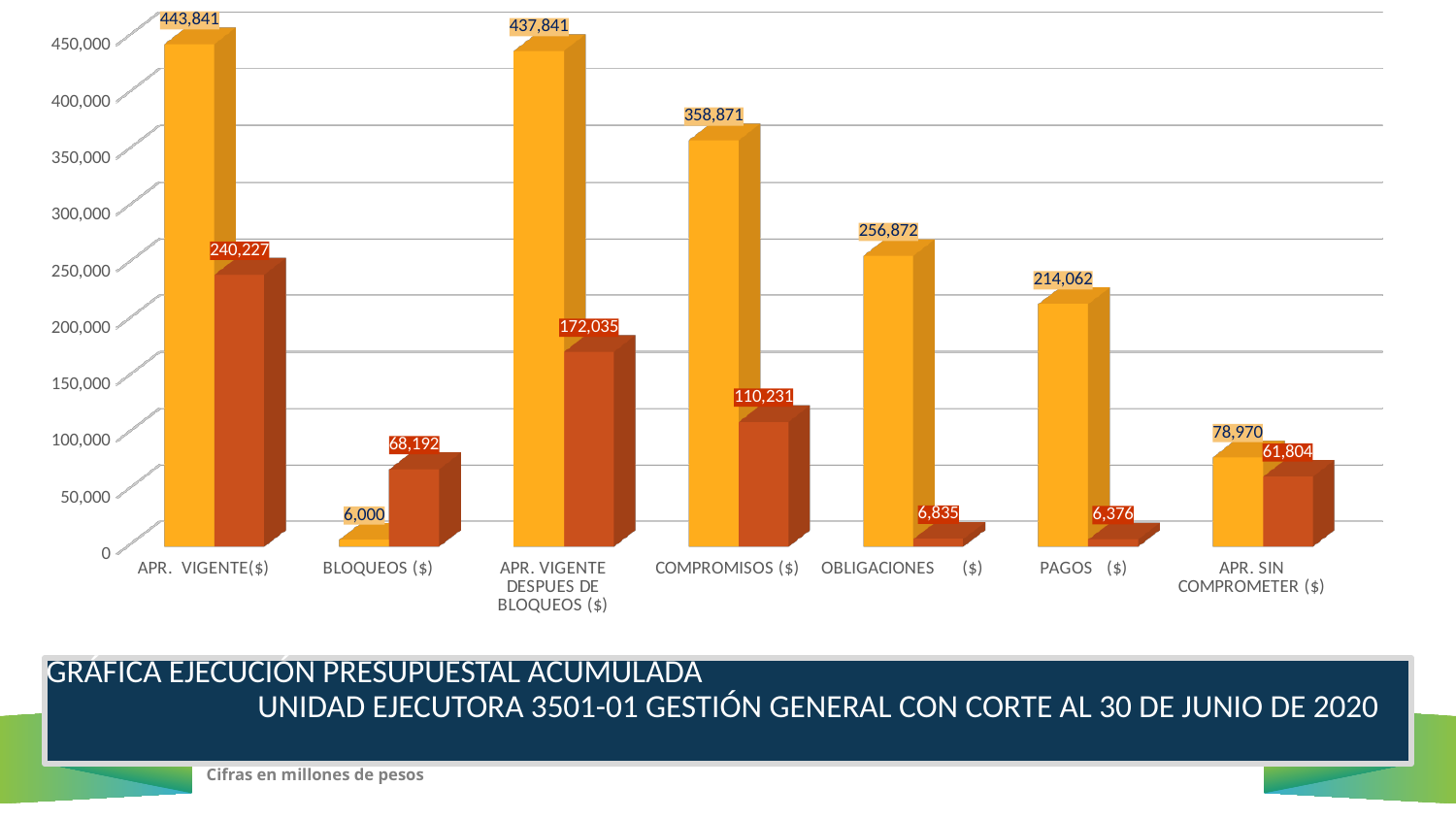
What is the difference between the yellow bar for APR. VIGENTE($) and the yellow bar for APR. VIGENTE DESPUES DE BLOQUEOS ($)? 6,000 Which is larger: the orange bar for OBLIGACIONES ($) or the orange bar for PAGOS ($)? OBLIGACIONES ($) What kind of chart is shown on the slide? Bar chart What is the value of the orange bar for APR. SIN COMPROMETER ($)? 61,804 Is the yellow bar for OBLIGACIONES ($) greater or less than 250,000? greater What is the value of the yellow bar for PAGOS ($)? 214,062 How many categories are shown on the x axis? 7 Which category has the lowest yellow bar? BLOQUEOS ($) What is the difference between the orange bar for COMPROMISOS ($) and the orange bar for OBLIGACIONES ($)? 103,396 What is the value of the orange bar for BLOQUEOS ($)? 68,192 Which category has the highest yellow bar? APR. VIGENTE($) What is the value of the yellow bar for COMPROMISOS ($)? 358,871